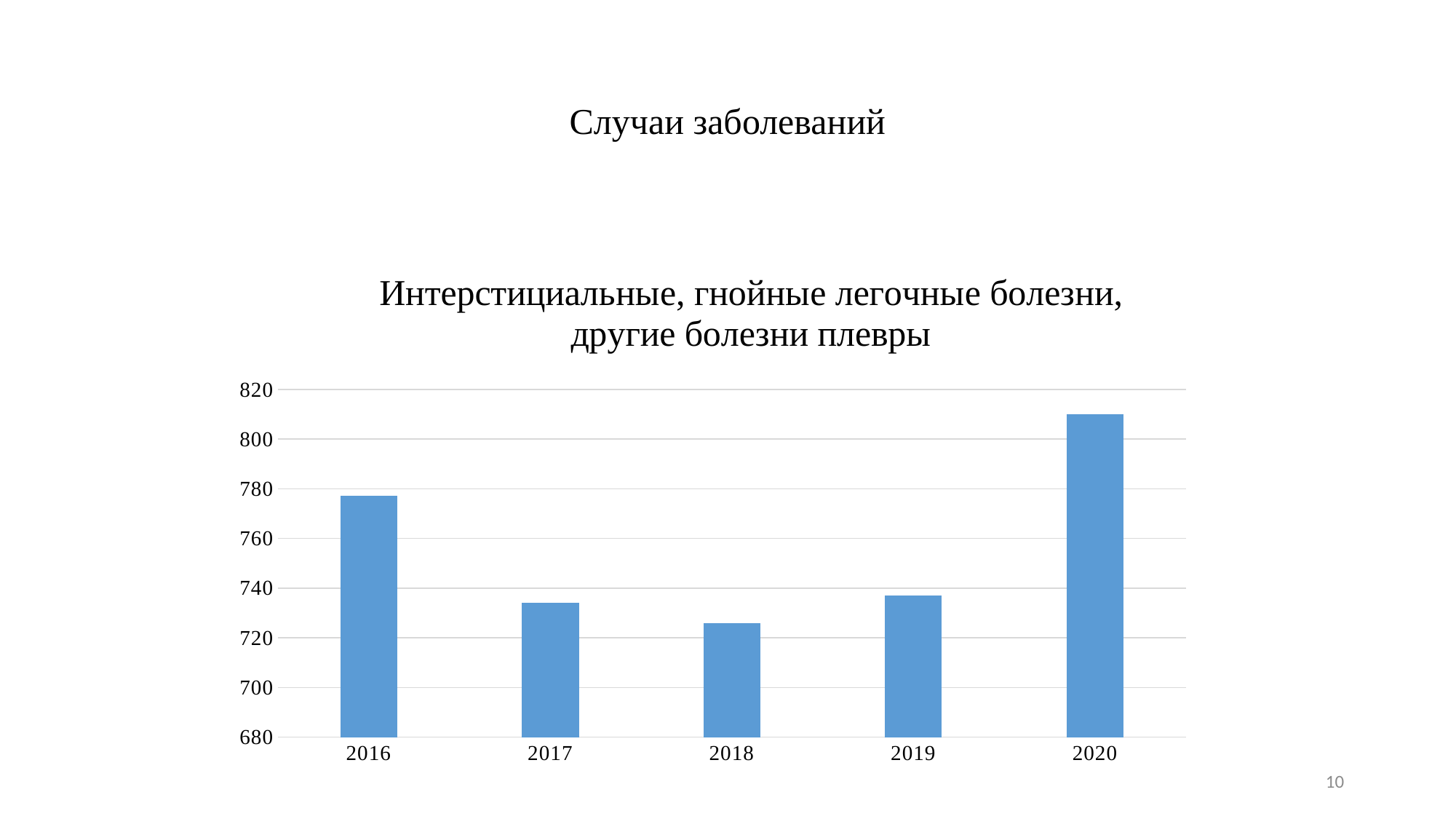
What kind of chart is shown on the slide? bar chart Which year has the highest value in the chart? 2020 Is the value for 2020 greater or less than 800? greater Does the value rise or fall from 2019 to 2020? rise Is the value for 2016 greater or less than 760? greater Which is larger, the value for 2016 or the value for 2017? 2016 Is the value for 2019 greater or less than 720? greater How many years are shown on the x axis of the chart? 5 What is the title of the chart? Интерстициальные, гнойные легочные болезни, другие болезни плевры Which year has the lowest value in the chart? 2018 What is the lowest value shown on the y axis of the chart? 680